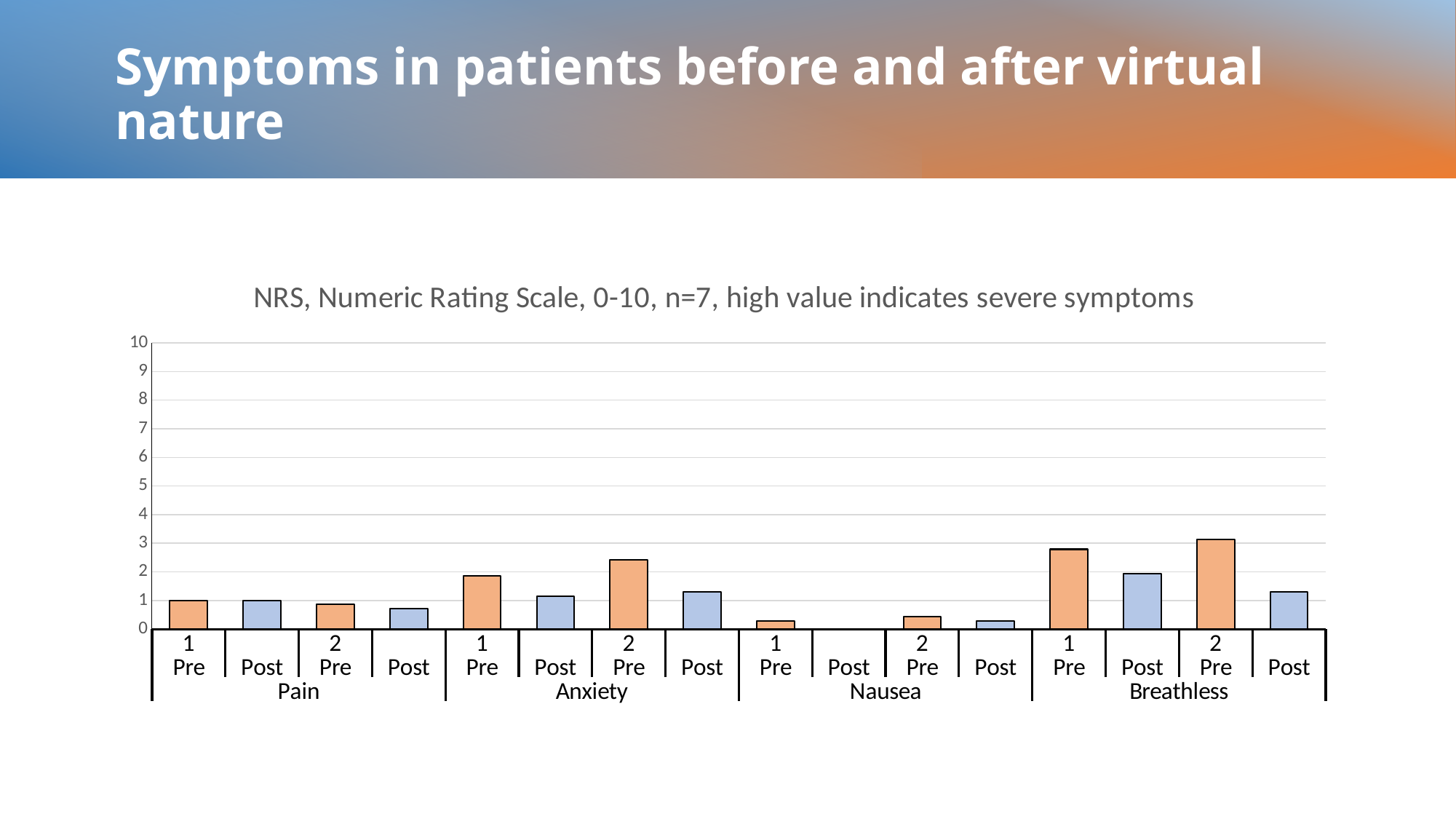
Is the value for Nausea 1 Pre greater or less than 1? less Which is larger, the value for Anxiety 2 Pre or the value for Anxiety 1 Pre? Anxiety 2 Pre Is the value for Anxiety 2 Pre greater or less than 2? greater How many symptom groups are shown along the x axis of the chart? 4 What is the maximum value shown on the vertical axis of the chart? 10 What is the title of the chart? NRS, Numeric Rating Scale, 0-10, n=7, high value indicates severe symptoms Which symptom group contains the tallest bar in the chart? Breathless What kind of chart is shown on the slide? bar chart Is the value for Anxiety 1 Pre greater or less than 2? less Which symptom group contains the lowest bars in the chart? Nausea